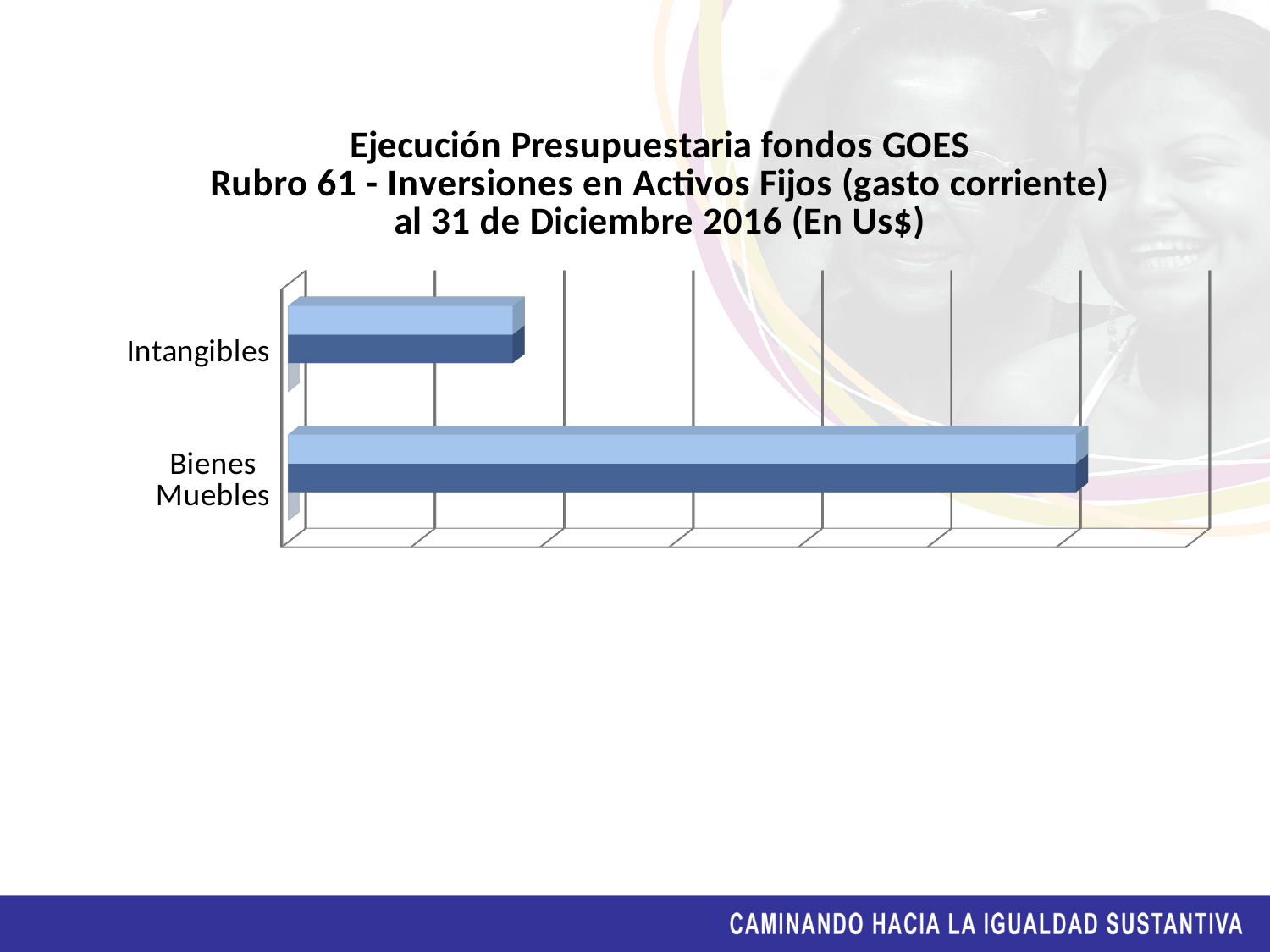
How many categories are plotted in the chart? 2 Which category has the lowest value in the chart? Intangibles What is the first line of the chart's title? Ejecución Presupuestaria fondos GOES Which category has the highest value in the chart? Bienes Muebles What kind of chart is shown on the slide? Bar chart Are the bars in the chart drawn horizontally or vertically? Horizontally According to the chart title, in what currency are the values expressed? Us$ Which is larger, the value for Bienes Muebles or the value for Intangibles? Bienes Muebles